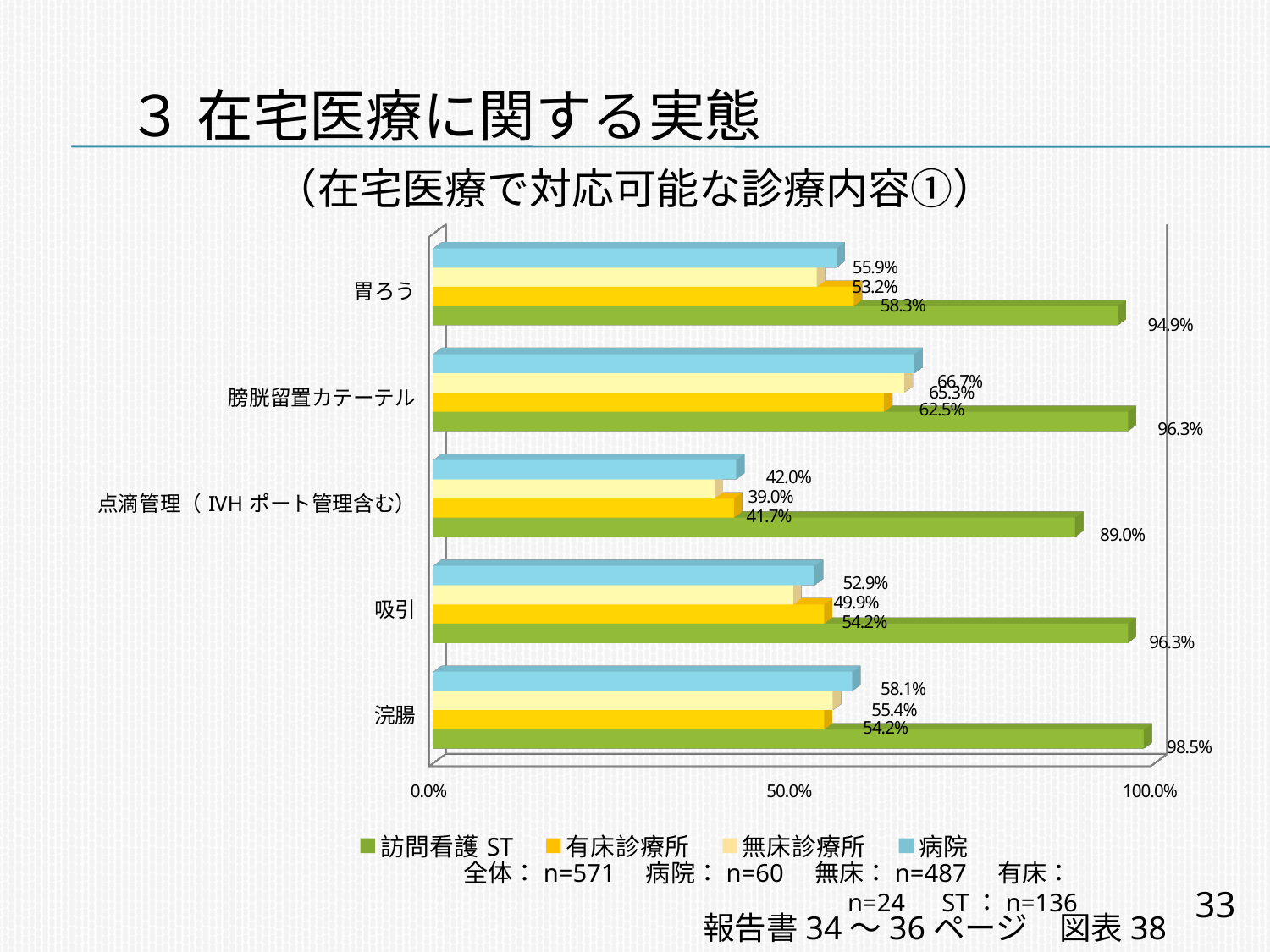
What is the value for 無床診療所 in the 点滴管理（IVHポート管理含む） category? 39.0% What is the difference between the 訪問看護ST value and the 病院 value in the 浣腸 category? 40.4 percentage points Is the value for 病院 in the 点滴管理（IVHポート管理含む） category greater or less than 50.0%? less What is the value for 病院 in the 膀胱留置カテーテル category? 66.7% How many series does the legend list? 4 Which category has the lowest value for 病院? 点滴管理（IVHポート管理含む） What is the value for 有床診療所 in the 浣腸 category? 54.2% What kind of chart is shown on the slide? bar chart What is the value for 訪問看護ST in the 胃ろう category? 94.9% In the 吸引 category, which is larger: the value for 有床診療所 or the value for 無床診療所? 有床診療所 Which category has the highest value for 訪問看護ST? 浣腸 How many categories are shown on the chart? 5